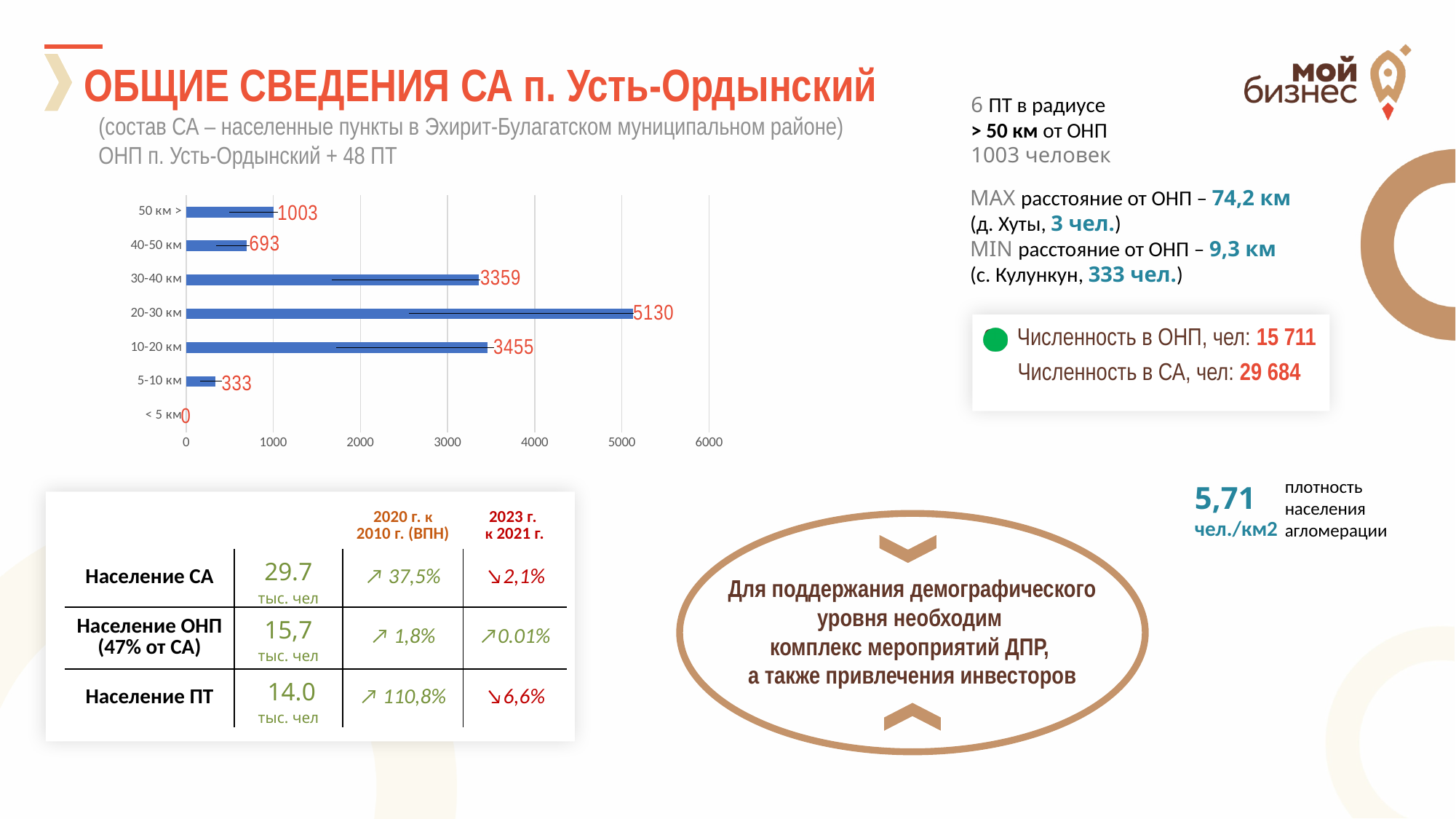
What is the value for the 20-30 км category in the bar chart? 5130 What is the value for the 5-10 км category in the bar chart? 333 Which category has the lowest value in the bar chart? < 5 км What is the difference between the values for 20-30 км and 10-20 км in the bar chart? 1675 What is the difference between the values for 30-40 км and 40-50 км in the bar chart? 2666 Which category has the highest value in the bar chart? 20-30 км Which is larger in the bar chart: the value for 10-20 км or the value for 30-40 км? 10-20 км What is the value for the 40-50 км category in the bar chart? 693 What is the value for the 50 км > category in the bar chart? 1003 How many categories are shown in the bar chart? 7 What type of chart is shown on the slide? bar chart Is the value for 30-40 км in the bar chart greater or less than 3000? greater